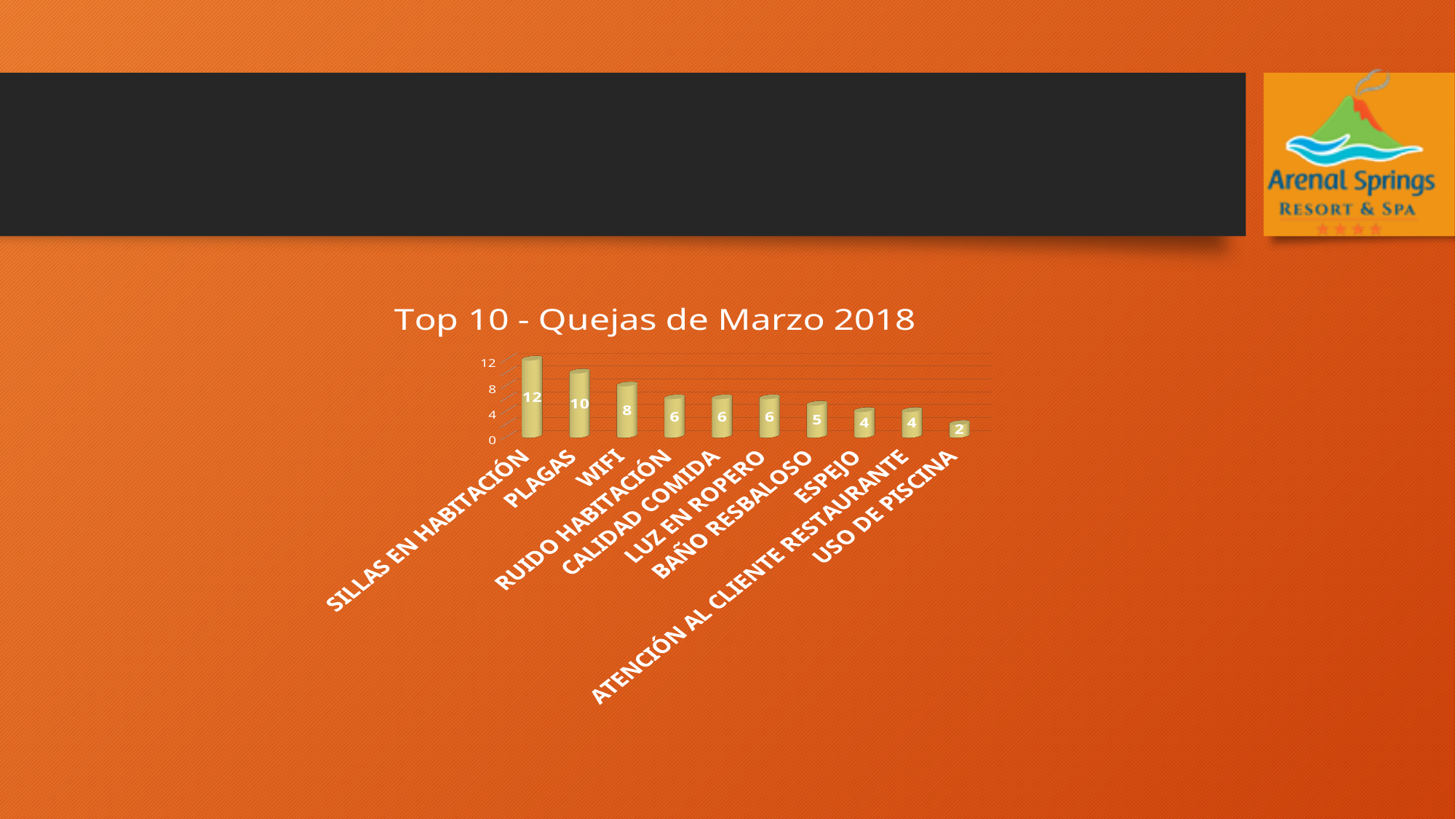
What is the value for PLAGAS? 10 What is the difference between the values for SILLAS EN HABITACIÓN and PLAGAS? 2 What is the title of the chart? Top 10 - Quejas de Marzo 2018 What is the value for WIFI? 8 Do the values rise or fall from left to right along the x axis? Fall What is the value for USO DE PISCINA? 2 Which is larger, the value for BAÑO RESBALOSO or the value for ESPEJO? BAÑO RESBALOSO Which category has the highest value? SILLAS EN HABITACIÓN What kind of chart is shown on the slide? Bar chart What is the value for SILLAS EN HABITACIÓN? 12 Which category has the lowest value? USO DE PISCINA How many categories are shown in the chart? 10